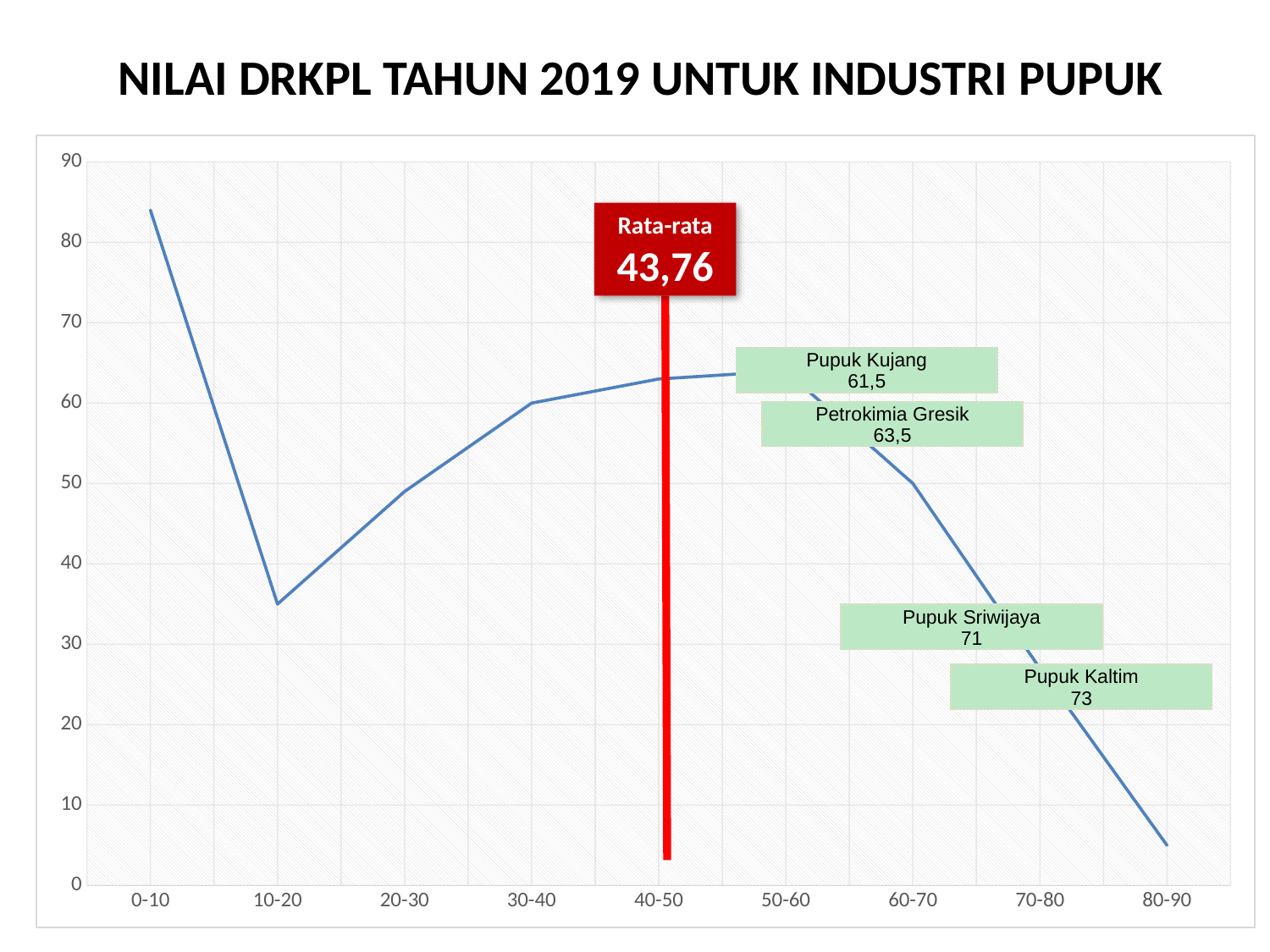
Which x-axis category has the highest value on the line? 0-10 What average (Rata-rata) value is shown in the red label on the chart? 43,76 Is the value for 0-10 greater or less than 80? greater Is the value for 10-20 greater or less than 40? less Is the value for 80-90 greater or less than 10? less What is the title of the chart on the slide? NILAI DRKPL TAHUN 2019 UNTUK INDUSTRI PUPUK How many categories are shown along the x axis? 9 What is the difference between the labelled values for Pupuk Kaltim (73) and Pupuk Sriwijaya (71)? 2 Which x-axis category has the lowest value on the line? 80-90 What kind of chart is shown on the slide? line chart Do the values rise or fall along the x axis from 50-60 to 80-90? fall Which is larger, the value for 30-40 or the value for 70-80? 30-40